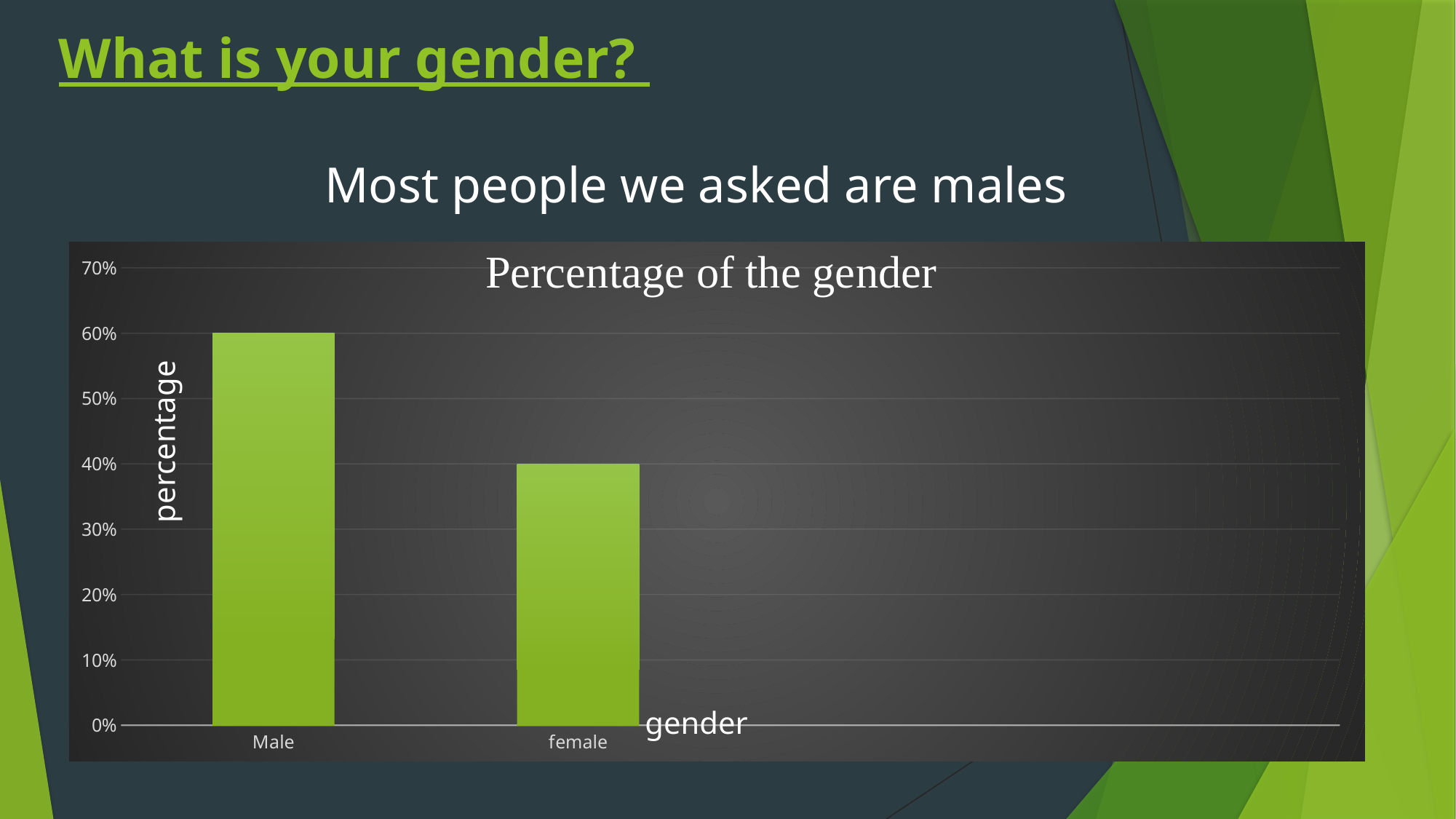
What is the percentage for female? 40% What is the difference between the Male and female percentages? 20% What is the title of the chart? Percentage of the gender Which gender has the lowest percentage? female How many categories are shown on the x axis? 2 What is the label of the vertical axis? percentage Is the value for Male greater or less than 50%? greater Which gender has the highest percentage? Male What type of chart is shown on the slide? bar chart What is the percentage for Male? 60% Which is larger, the percentage for Male or for female? Male Is the value for female greater or less than 50%? less